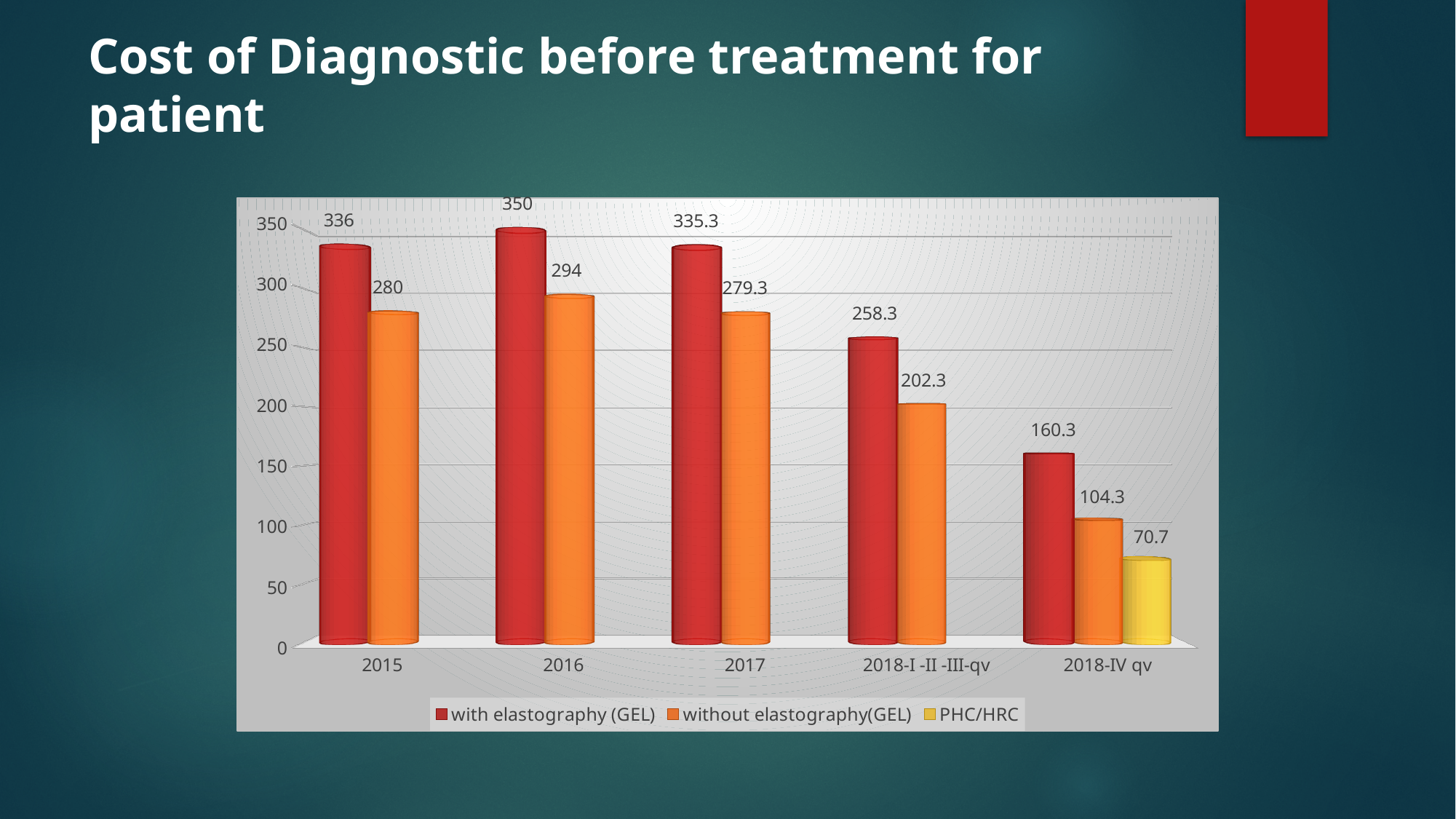
What is the value for 'with elastography (GEL)' in 2016? 350 How many series does the legend list? 3 What is the title of the slide? Cost of Diagnostic before treatment for patient In which category is the 'without elastography(GEL)' value lowest? 2018-IV qv What kind of chart is shown on the slide? bar chart Do the 'with elastography (GEL)' values rise or fall from 2016 to 2018-IV qv? fall What is the difference between the 'with elastography (GEL)' and 'without elastography(GEL)' values in 2015? 56 Which is larger: 'with elastography (GEL)' in 2017 or 'without elastography(GEL)' in 2016? with elastography (GEL) in 2017 What is the value for PHC/HRC in 2018-IV qv? 70.7 What is the value for 'without elastography(GEL)' in 2018-I -II -III-qv? 202.3 In which category is the 'with elastography (GEL)' value highest? 2016 How many categories are shown on the x axis? 5